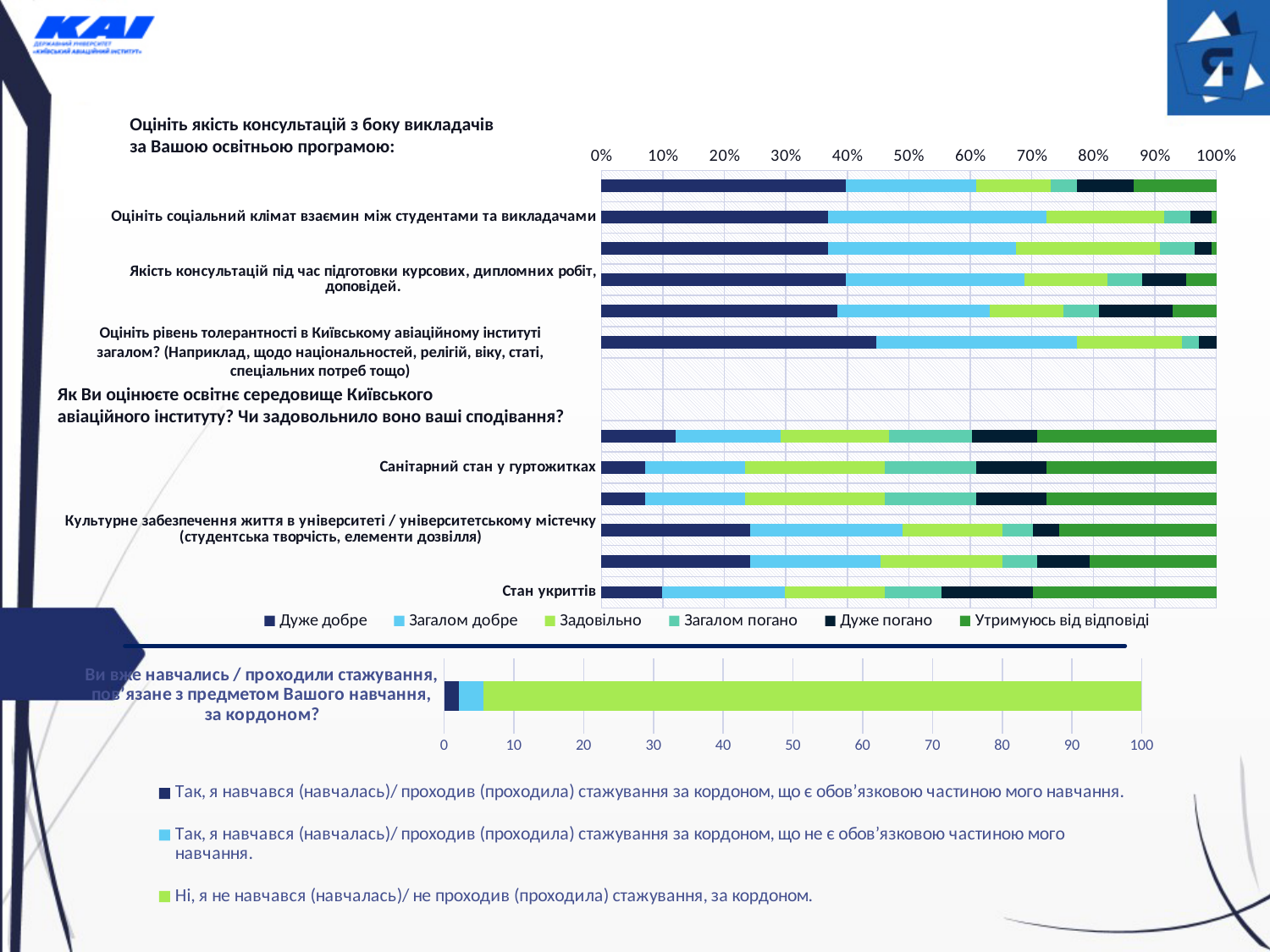
In the top chart, is the 'Дуже добре' share for 'Стан укриттів' greater or less than 20%? less In the top chart, which has the larger 'Дуже добре' share: 'Оцініть соціальний клімат взаємин між студентами та викладачами' or 'Стан укриттів'? Оцініть соціальний клімат взаємин між студентами та викладачами What kind of chart is the bottom chart about studying abroad? Stacked bar chart In the top chart, what is the last entry in the legend? Утримуюсь від відповіді In the bottom chart about studying abroad, which series has the largest segment? Ні, я не навчався (навчалась)/ не проходив (проходила) стажування, за кордоном. In the top chart, is the 'Дуже добре' share for 'Санітарний стан у гуртожитках' greater or less than 10%? less In the top chart, what is the highest value shown on the percentage axis? 100% In the bottom chart about studying abroad, how many series does the legend list? 3 In the top chart, is the 'Дуже добре' share for 'Оцініть соціальний клімат взаємин між студентами та викладачами' greater or less than 30%? greater What kind of chart is the top chart on the slide? Stacked bar chart In the top chart, how many series does the legend list? 6